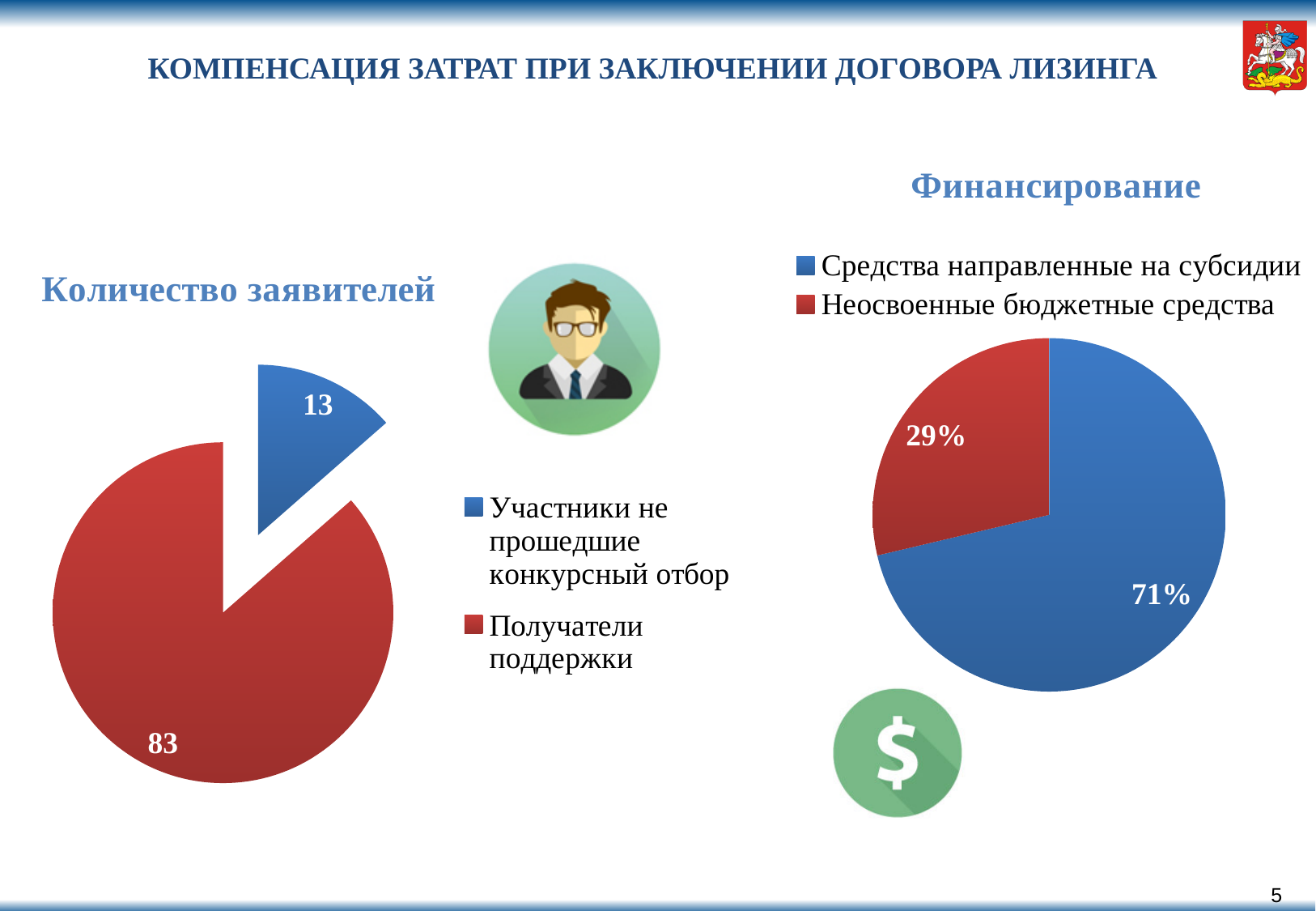
In the 'Финансирование' chart, what colour is the 'Неосвоенные бюджетные средства' slice? Red In the 'Количество заявителей' chart, what is the value for 'Получатели поддержки'? 83 In the 'Финансирование' chart, what share is labelled for 'Неосвоенные бюджетные средства'? 29% In the 'Количество заявителей' chart, what is the difference between 'Получатели поддержки' and 'Участники не прошедшие конкурсный отбор'? 70 In the 'Количество заявителей' chart, which category has the largest value? Получатели поддержки In the 'Финансирование' chart, which is larger: 'Средства направленные на субсидии' or 'Неосвоенные бюджетные средства'? Средства направленные на субсидии In the 'Количество заявителей' chart, what is the total of the two slices? 96 In the 'Финансирование' chart, which category has the smallest share? Неосвоенные бюджетные средства In the 'Финансирование' chart, what share is labelled for 'Средства направленные на субсидии'? 71% In the 'Количество заявителей' chart, what is the value for 'Участники не прошедшие конкурсный отбор'? 13 In the 'Количество заявителей' chart, how many slices does the pie have? 2 What type of chart is the 'Финансирование' chart? Pie chart